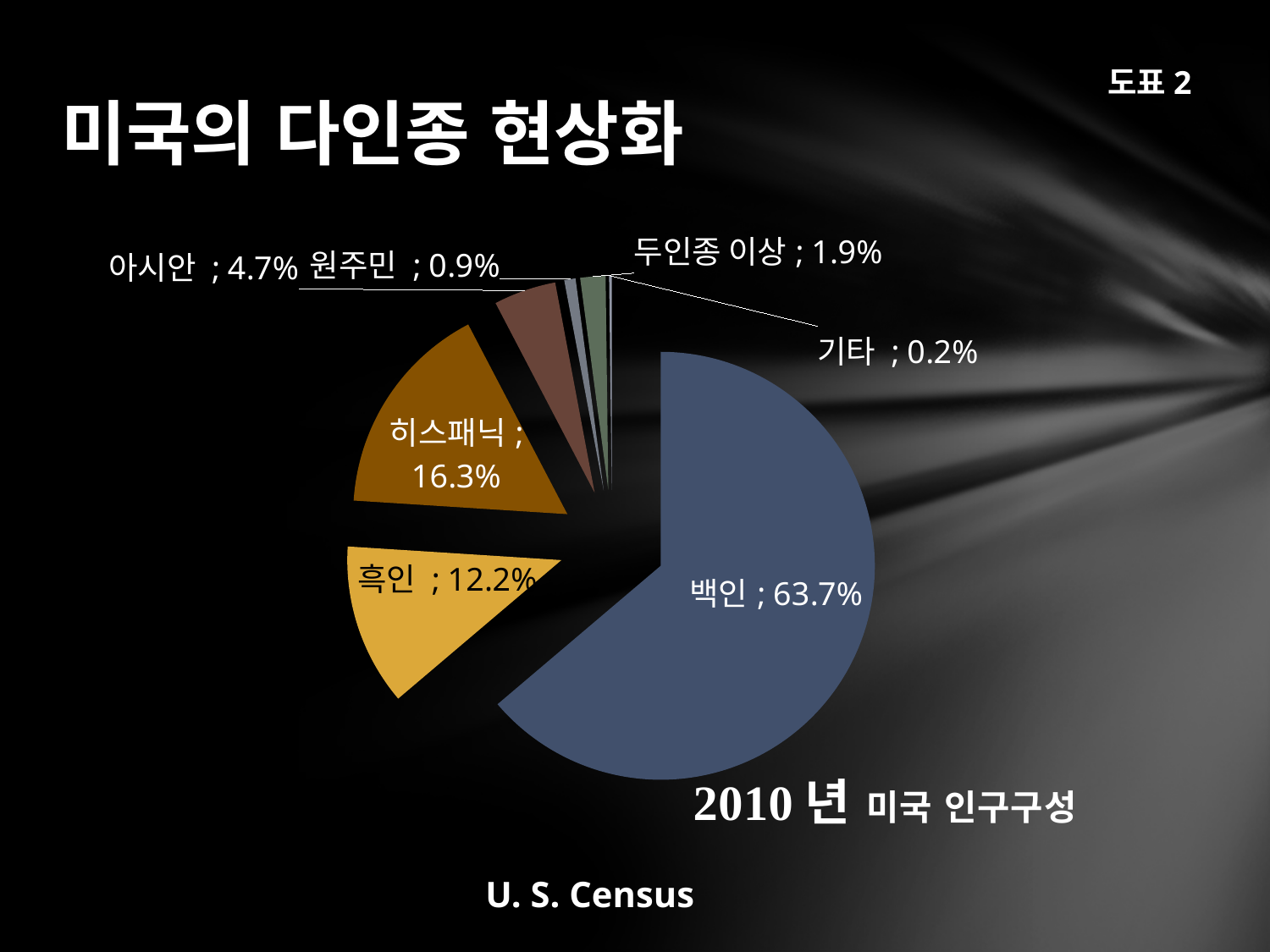
What is the value shown for 히스패닉? 16.3% Which category has the smallest slice of the pie? 기타 What kind of chart is shown on the slide? Pie chart What is the value for 아시안? 4.7% What is the difference between the values for 히스패닉 and 흑인? 4.1% What share of the pie does 백인 represent? 63.7% What percentage is labelled for 흑인? 12.2% What source is cited below the chart? U. S. Census How many categories are shown in the pie chart? 7 What percentage is shown for 두인종 이상? 1.9% Which category has the largest slice of the pie? 백인 Which is larger, the value for 원주민 or the value for 두인종 이상? 두인종 이상